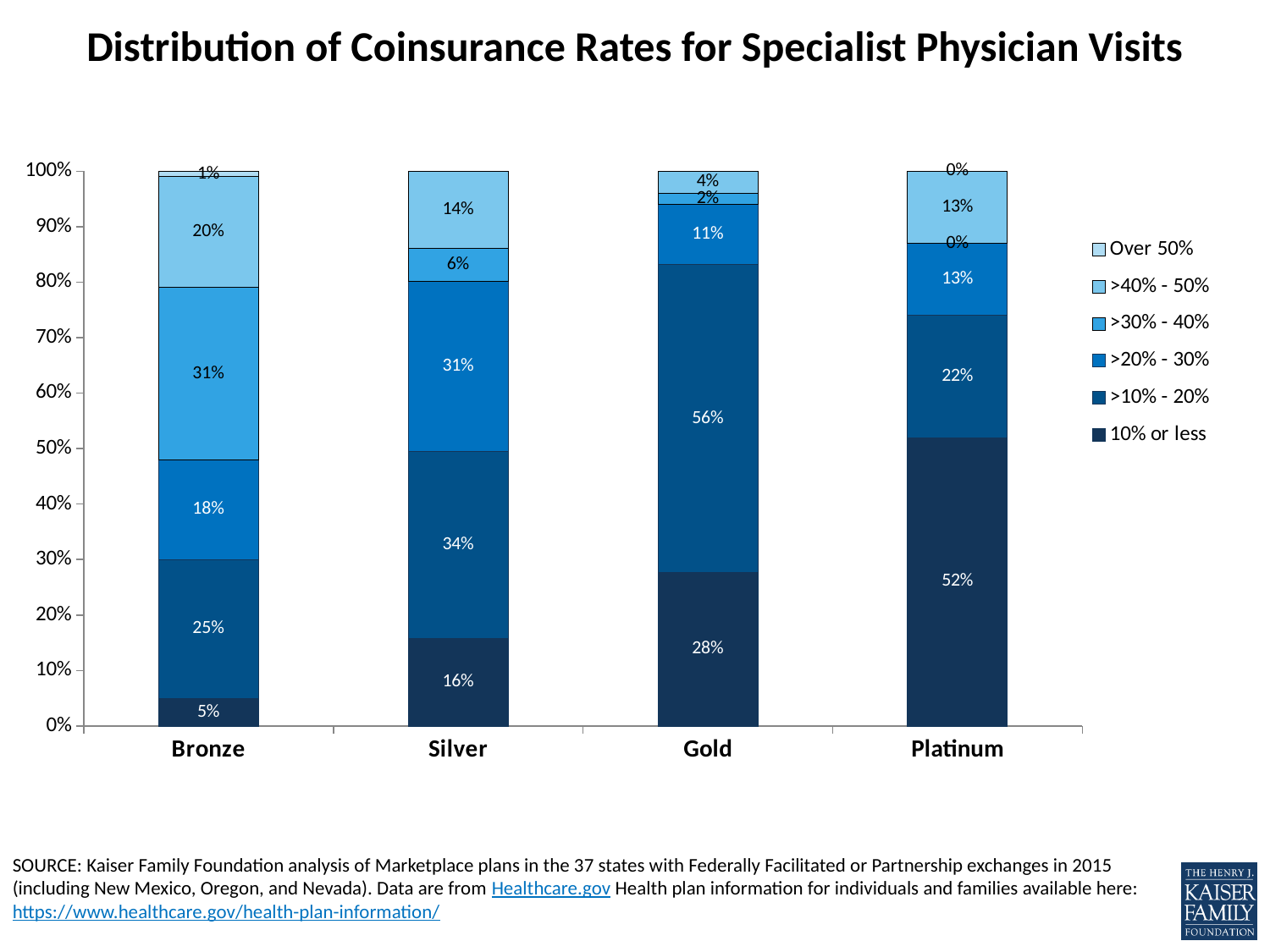
How many percentage points higher is the 10% or less share for Gold than for Silver? 12 percentage points Which has a larger share in the >10% - 20% category, Silver or Bronze? Silver What is the title of the chart? Distribution of Coinsurance Rates for Specialist Physician Visits Which plan tier has the highest share of plans with coinsurance of 10% or less? Platinum How many coinsurance categories does the legend list? 6 What percentage of Gold plans fall in the >10% - 20% coinsurance category? 56% What type of chart is shown on the slide? Stacked bar chart Which plan tier has the lowest share of plans with coinsurance of 10% or less? Bronze How many plan tiers are shown on the x axis? 4 What percentage of Silver plans fall in the >40% - 50% coinsurance category? 14% What percentage of Bronze plans fall in the >30% - 40% coinsurance category? 31% What percentage of Platinum plans have a coinsurance rate of 10% or less for specialist physician visits? 52%